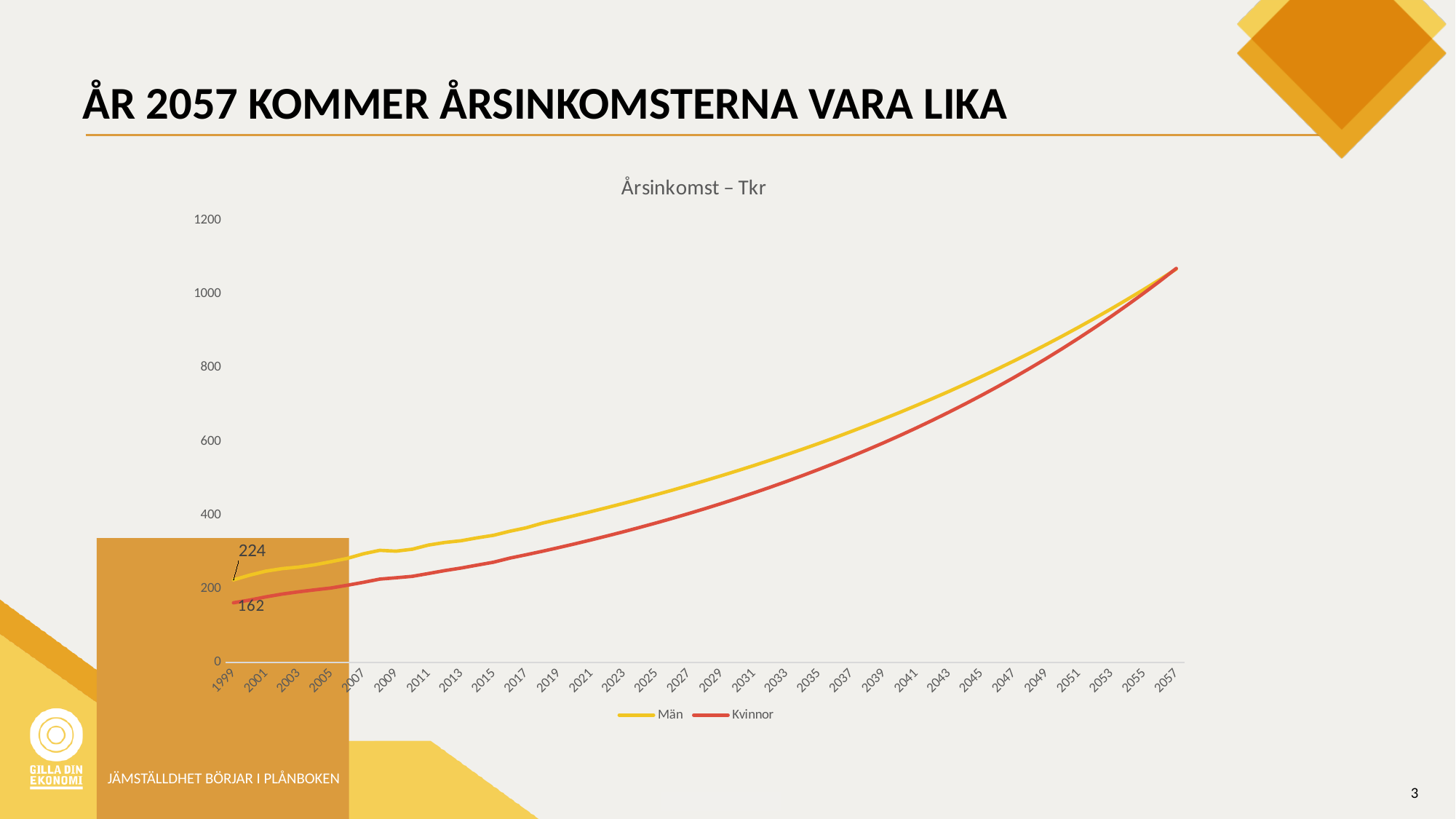
Is the value for Kvinnor in 2021 greater or less than 400? less How many series does the legend list? 2 Is the value for Kvinnor in 2045 greater or less than 600? greater In 1999, which series has the higher value, Män or Kvinnor? Män Do the values for Kvinnor rise or fall from 1999 to 2057? Rise Is the value for Män in 2049 greater or less than 800? greater What is the value for Kvinnor in 1999? 162 What kind of chart is shown on the slide? Line chart What is the difference between the Män and Kvinnor values in 1999? 62 Which series is higher in 2031, Män or Kvinnor? Män What is the value for Män in 1999? 224